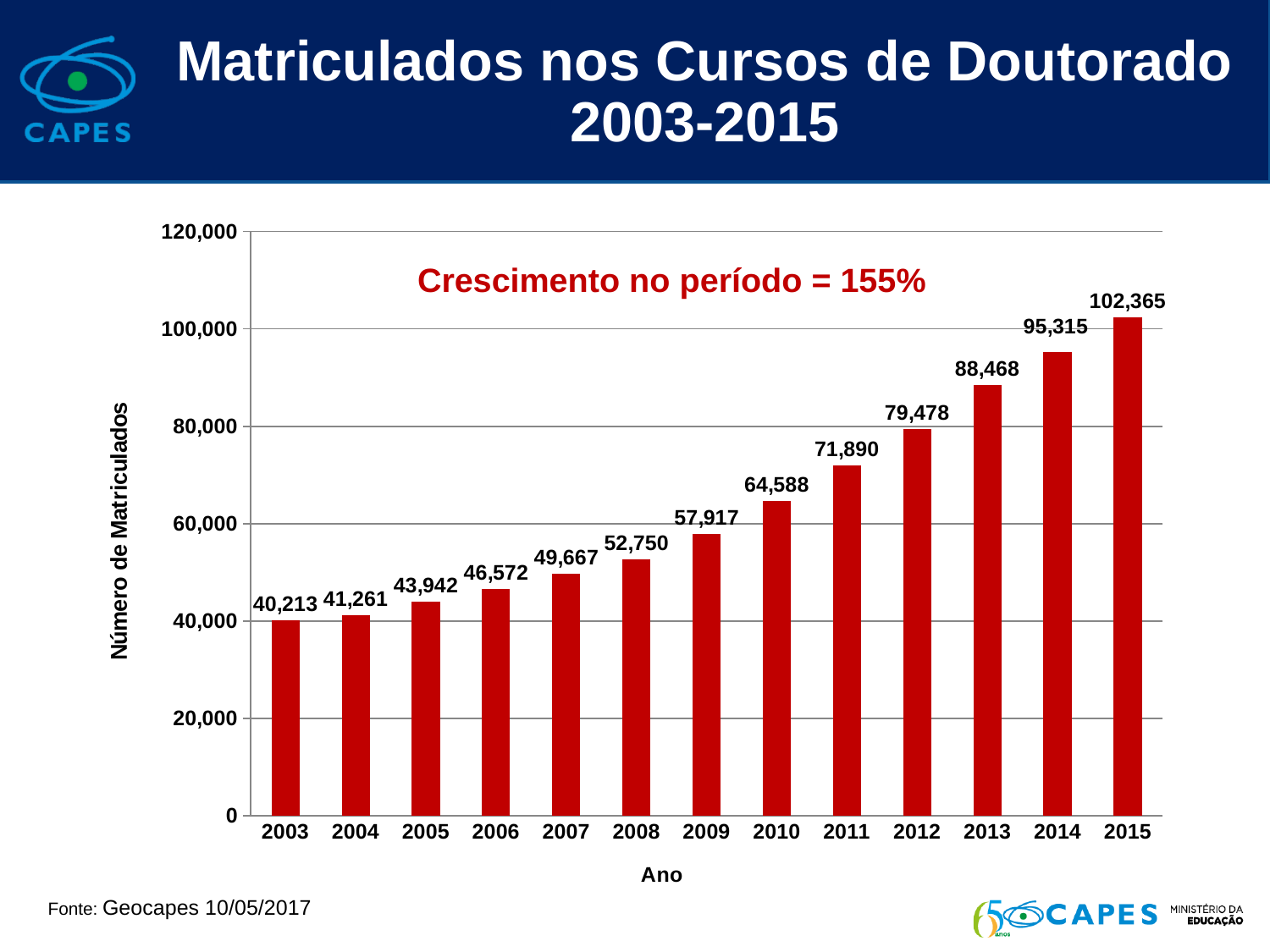
Is the value for 2012 greater or less than 80,000? less What kind of chart is shown on the slide? bar chart What is the value shown for 2013? 88,468 What is the difference between the values for 2015 and 2014? 7,050 Which year has the lowest number of enrolled students? 2003 What is the value shown for 2003? 40,213 How many years are shown on the x axis? 13 Which year has the highest number of enrolled students? 2015 What is the number of enrolled doctoral students in 2009? 57,917 Which is larger, the value for 2011 or the value for 2008? 2011 Do the values rise or fall from 2003 to 2015? rise What is the difference between the values for 2010 and 2009? 6,671